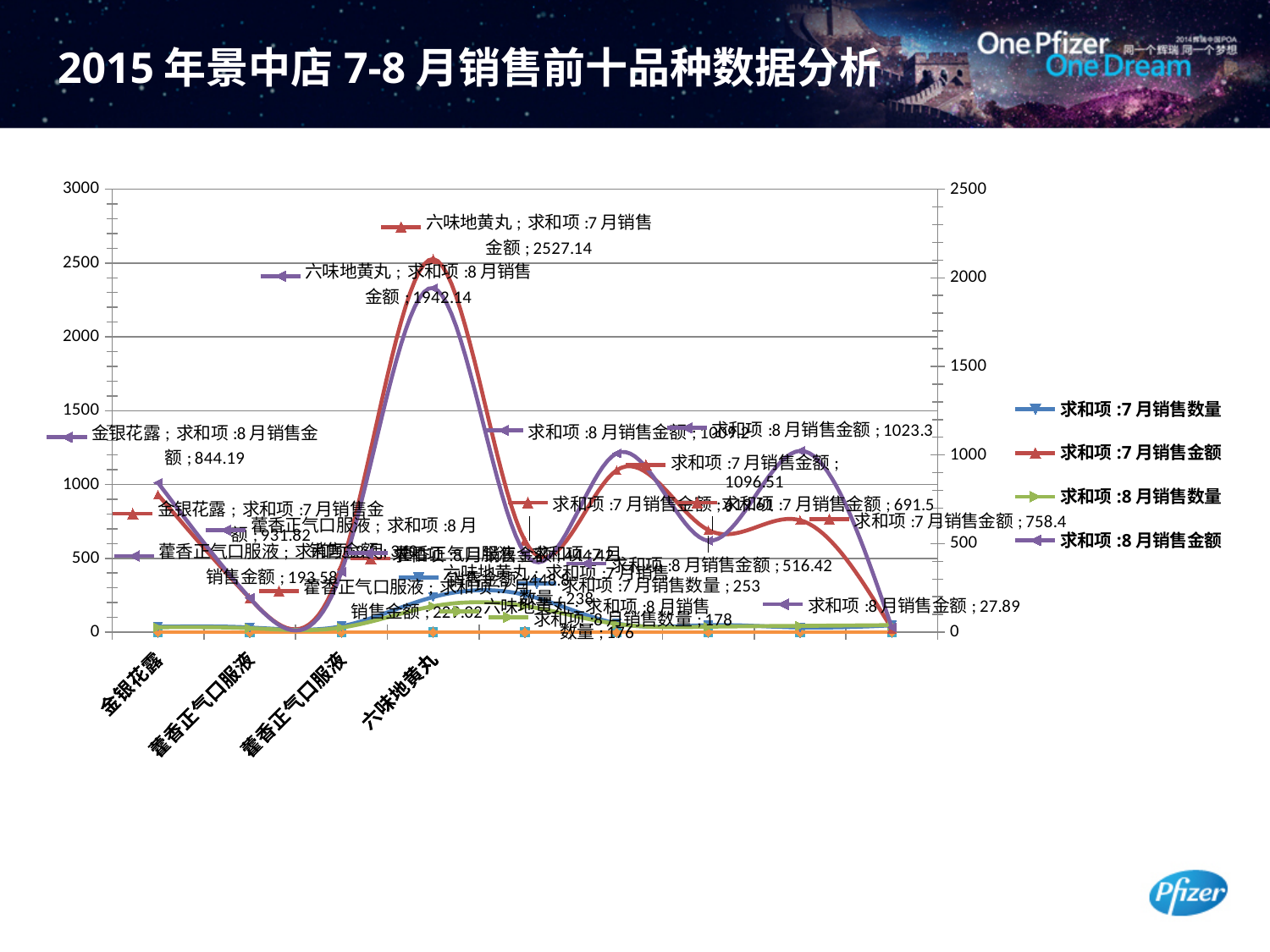
What is the 求和项:7月销售数量 value for 六味地黄丸? 238 What is the 求和项:8月销售金额 value for 金银花露? 844.19 For 金银花露, which is larger: the 求和项:7月销售金额 value or the 求和项:8月销售金额 value? 求和项:7月销售金额 What is the title of the slide containing the chart? 2015年景中店7-8月销售前十品种数据分析 Which product has the highest 求和项:7月销售金额 value? 六味地黄丸 What is the difference between the 求和项:7月销售金额 and 求和项:8月销售金额 values for 六味地黄丸? 585 What is the 求和项:7月销售金额 value for 六味地黄丸? 2527.14 What is the 求和项:8月销售数量 value for 六味地黄丸? 176 What is the 求和项:8月销售金额 value for 六味地黄丸? 1942.14 What kind of chart is shown on the slide? line chart How many series does the chart legend list? 4 What is the 求和项:7月销售金额 value for 金银花露? 931.82